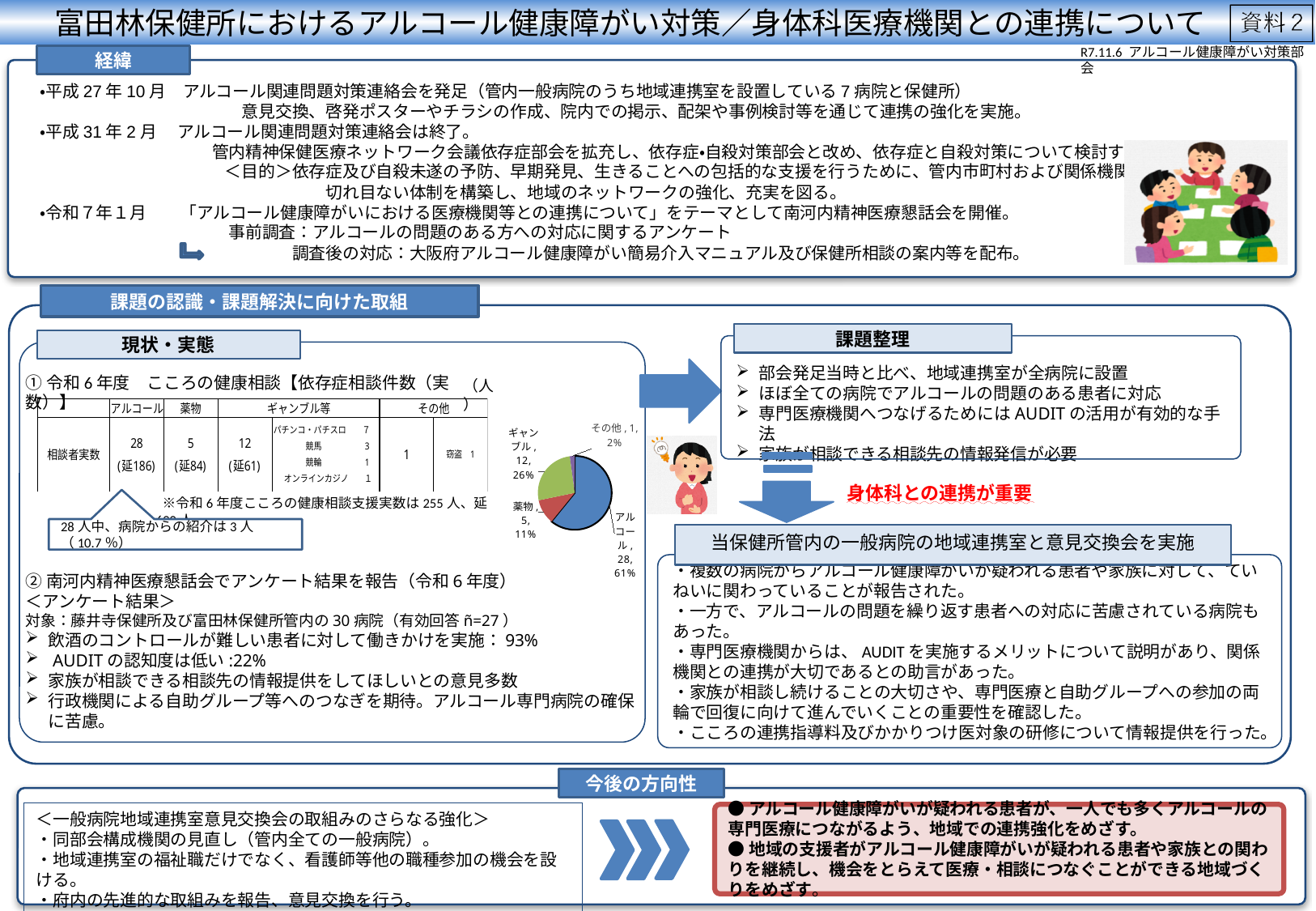
In the pie chart, what is the value for 薬物? 5 In the pie chart, what is the value for アルコール? 28 In the pie chart, what percentage share does その他 have? 2% In the pie chart, how many slices (categories) are there? 4 What kind of chart is shown in the 現状・実態 section of the slide? pie chart In the pie chart, which category has the smallest slice? その他 In the pie chart, what percentage share does ギャンブル have? 26% In the pie chart, which category has the largest slice? アルコール In the pie chart, what percentage share does アルコール have? 61% In the pie chart, what is the value for ギャンブル? 12 In the pie chart, what is the difference between the values for アルコール and ギャンブル? 16 In the pie chart, which is larger, the value for 薬物 or the value for ギャンブル? ギャンブル